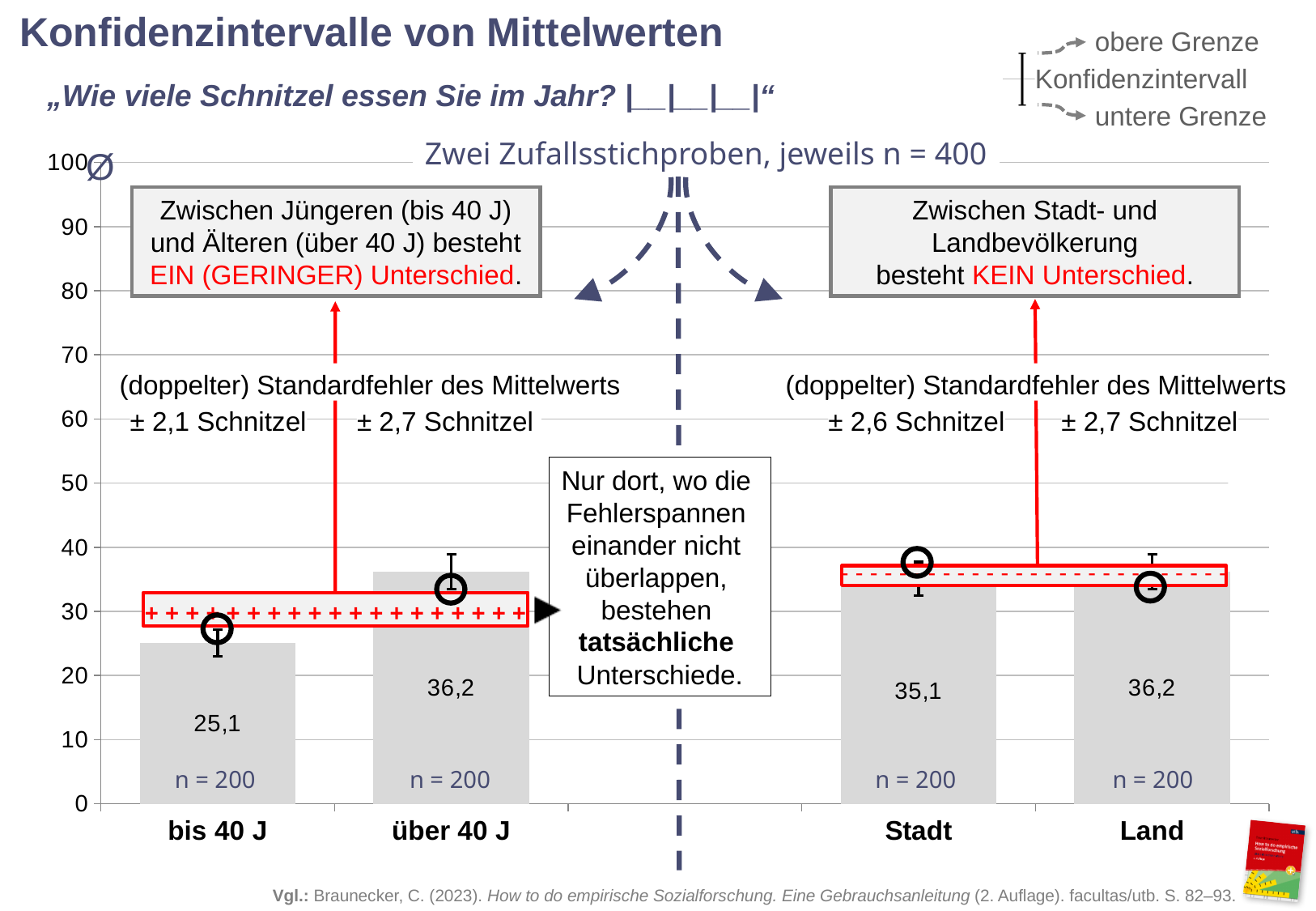
What is the highest value on the y axis? 100 What is the mean value shown for the 'Stadt' bar? 35,1 How many bars are shown in the chart? 4 What is the mean value shown for the 'bis 40 J' bar? 25,1 What kind of chart is shown on the slide? bar chart What sample size (n) is shown for each bar? n = 200 What is the (doppelter) Standardfehler des Mittelwerts given for 'Stadt'? ± 2,6 Schnitzel What is the mean value shown for the 'Land' bar? 36,2 Which category has the lowest mean value? bis 40 J What is the difference between the mean values for 'über 40 J' and 'bis 40 J'? 11,1 Is the value for 'bis 40 J' greater or less than 30? less Which is larger, the mean value for 'Stadt' or for 'Land'? Land